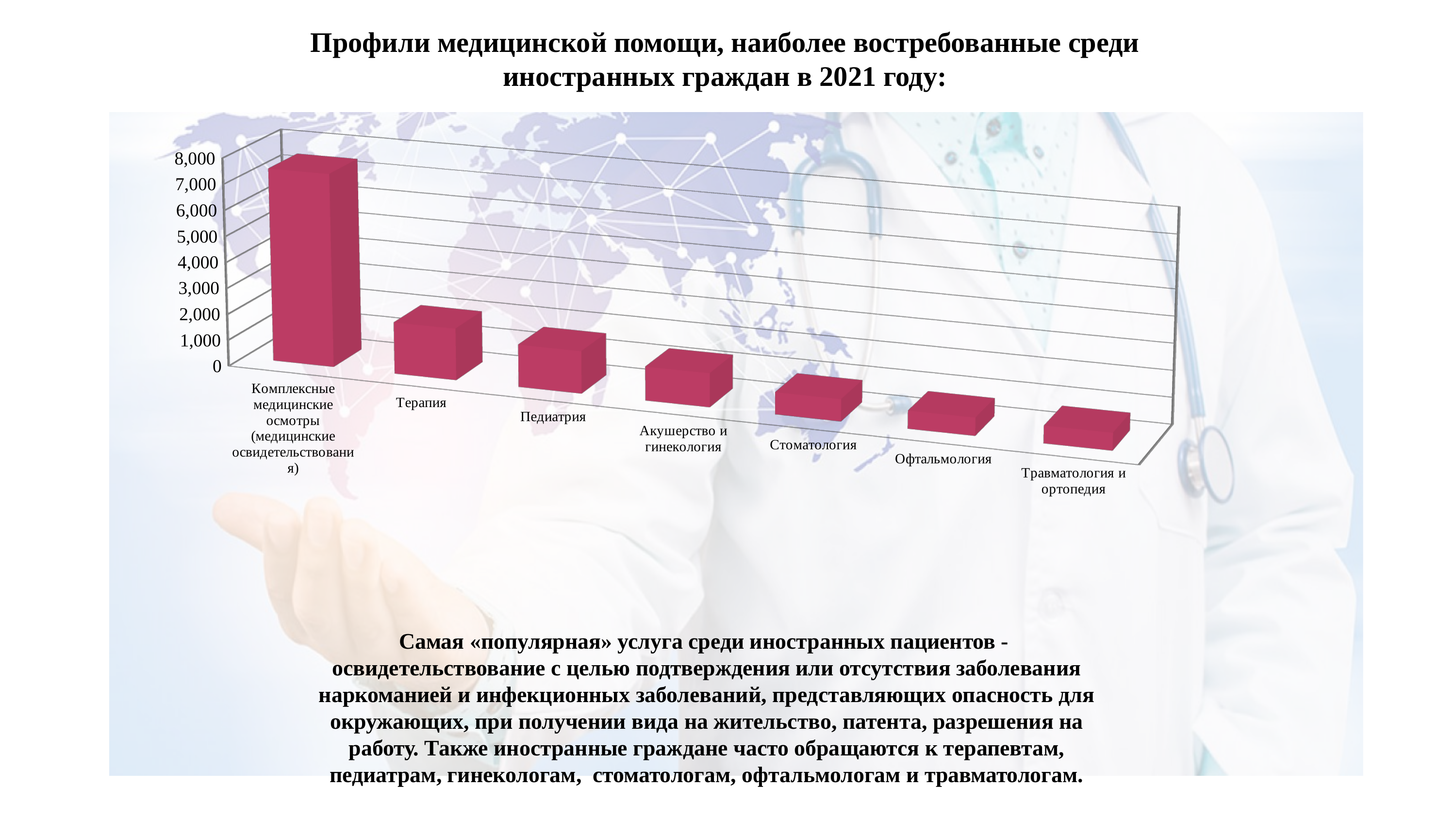
What is the highest value shown on the vertical axis of the chart? 8,000 Which has a larger value, Терапия or Стоматология? Терапия Is the value for Травматология и ортопедия greater or less than 3,000? less Which medical profile has the highest value in the chart? Комплексные медицинские осмотры (медицинские освидетельствования) Is the value for Терапия greater or less than 4,000? less Which has a larger value, Педиатрия or Офтальмология? Педиатрия Which medical profile has the lowest value in the chart? Травматология и ортопедия What kind of chart is shown on the slide? bar chart Do the values rise or fall moving from left to right along the x axis? fall Is the value for Комплексные медицинские осмотры greater or less than 5,000? greater What is the title of the chart on the slide? Профили медицинской помощи, наиболее востребованные среди иностранных граждан в 2021 году How many categories (medical profiles) are shown in the chart? 7